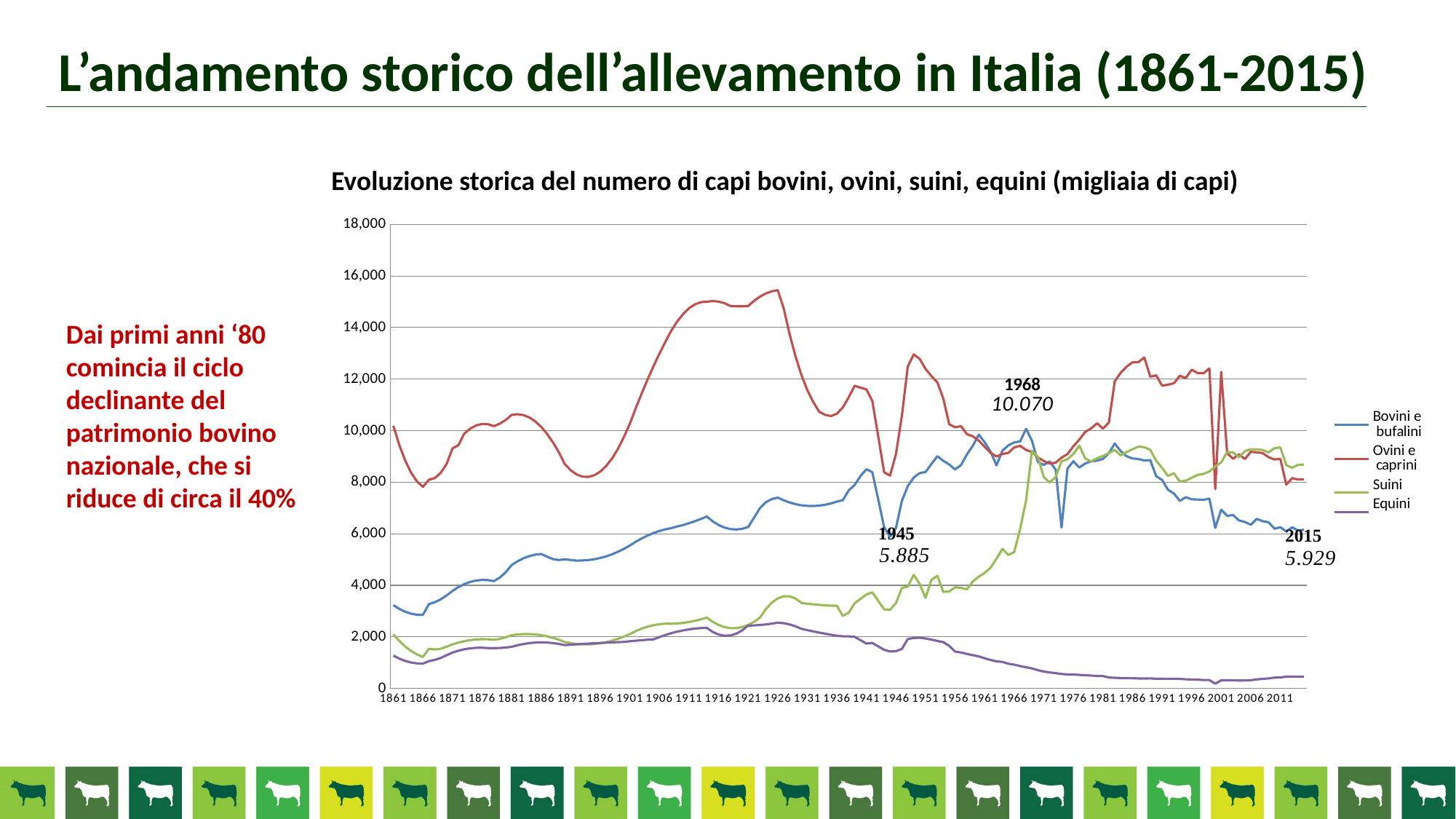
What is the labelled value for Bovini e bufalini in 1945? 5.885 What is the labelled value for Bovini e bufalini in 1968? 10.070 Which series has the lowest value in 2011? Equini What kind of chart is shown on the slide? line chart Is the value for Equini in 2011 greater or less than 2,000? less How many series does the legend list? 4 Which labelled Bovini e bufalini value is larger, 1945 or 2015? 2015 What is the difference between the labelled Bovini e bufalini values for 1968 and 1945? 4.185 Which series has the highest value in 1926? Ovini e caprini What is the title of the chart? Evoluzione storica del numero di capi bovini, ovini, suini, equini (migliaia di capi) What is the labelled value for Bovini e bufalini in 2015? 5.929 Is the value for Ovini e caprini in 1926 greater or less than 14,000? greater